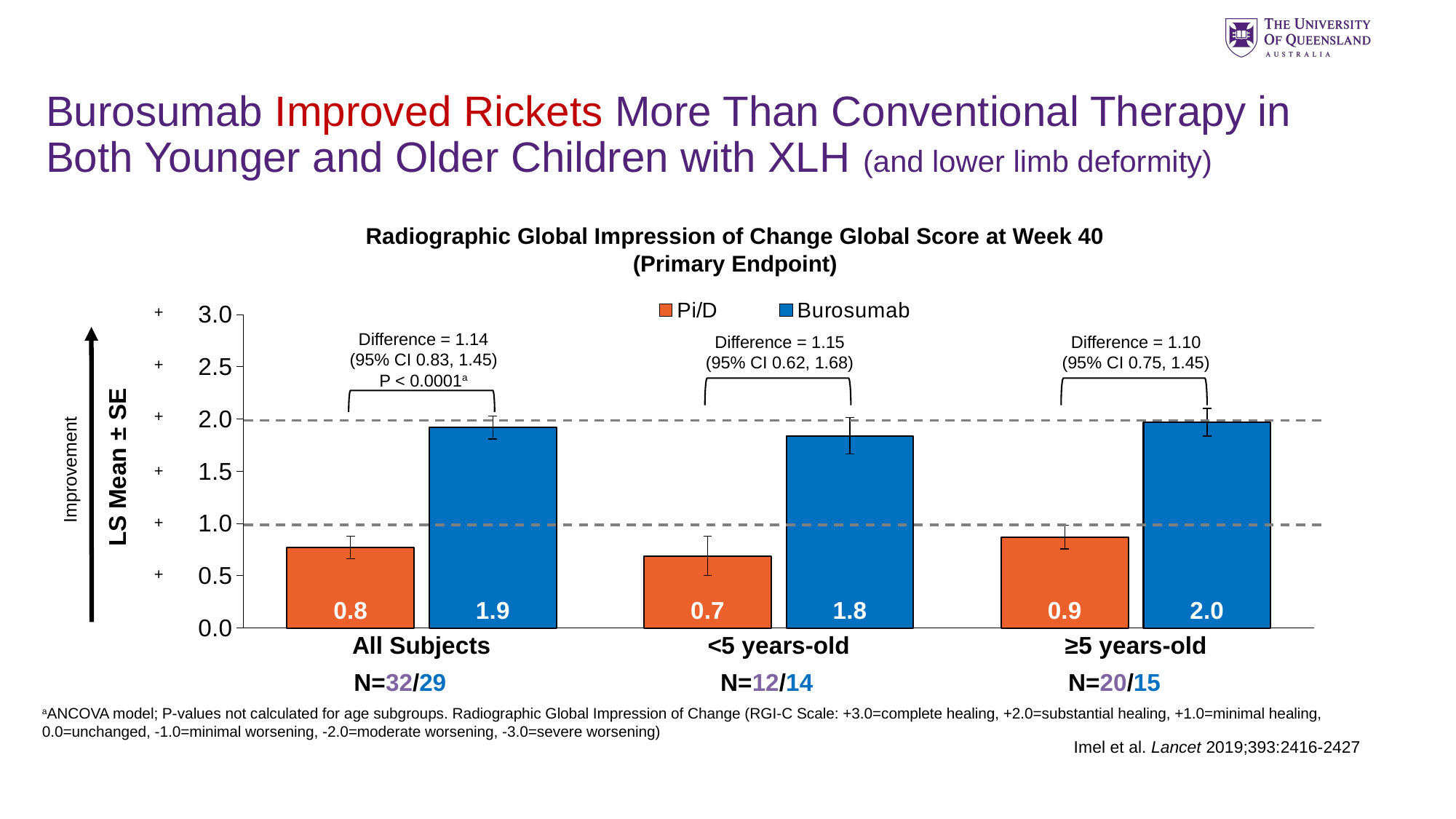
What is the Pi/D value for the ≥5 years-old group? 0.9 What is the Burosumab value for the ≥5 years-old group? 2.0 What kind of chart is shown on the slide? Bar chart What is the Pi/D value for the <5 years-old group? 0.7 What is the Burosumab value for All Subjects? 1.9 What is the difference between the Burosumab and Pi/D values for All Subjects, based on the bar labels? 1.1 Which is larger for the <5 years-old group, the Pi/D value or the Burosumab value? Burosumab Which group has the highest Burosumab value? ≥5 years-old How many groups are shown on the x axis? 3 Which group has the lowest Pi/D value? <5 years-old How many series does the legend list? 2 Is the Pi/D value for All Subjects greater or less than 1.0? less